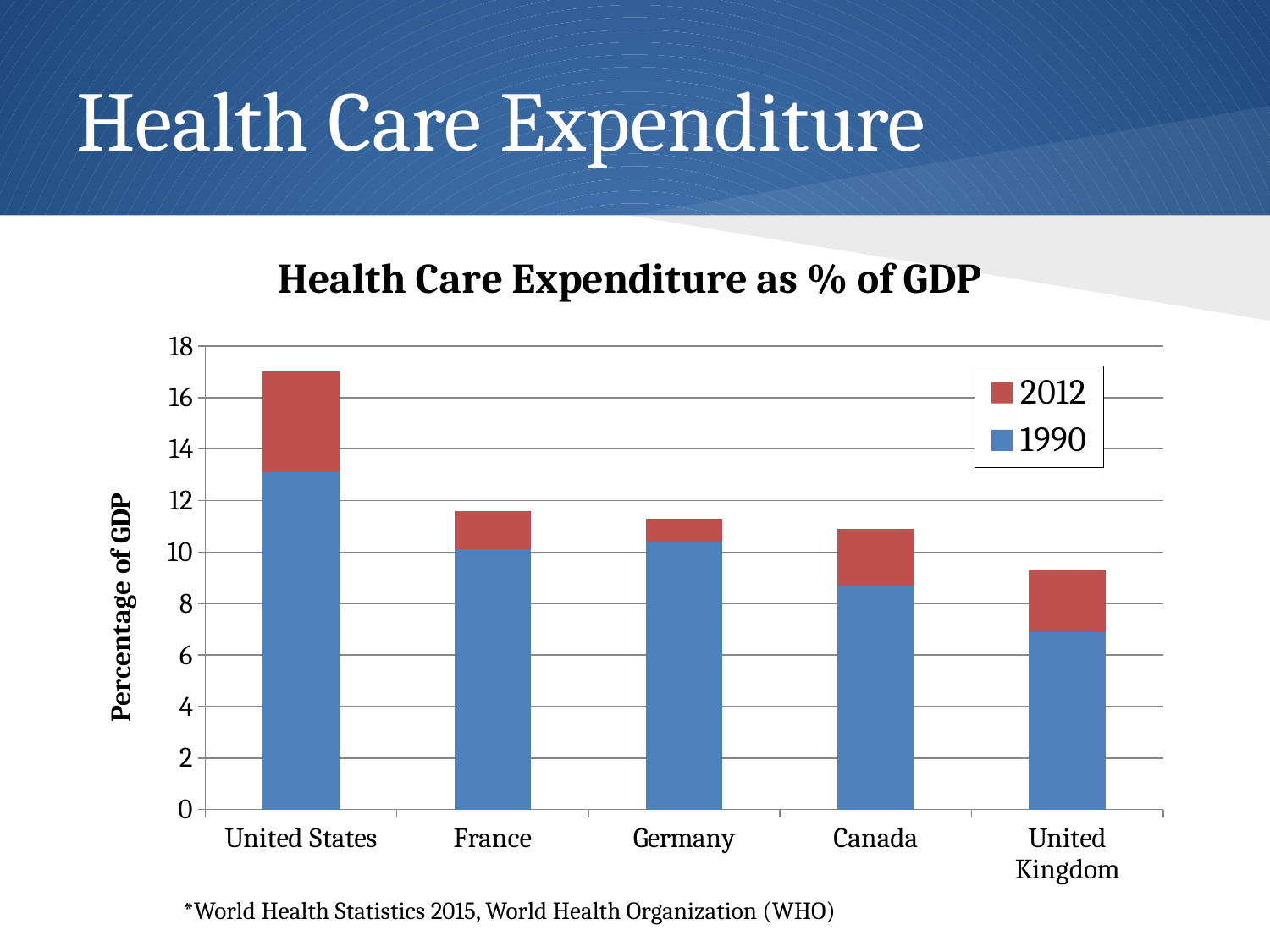
How many series does the chart's legend list? 2 Which country has the shortest stacked bar in the chart? United Kingdom Do the total stacked bar heights rise or fall moving from left to right along the x axis? fall How many countries are shown on the x axis of the chart? 5 Which has the larger total stacked bar, Canada or the United Kingdom? Canada Is the 1990 value for the United Kingdom greater or less than 8? less Is the total stacked value for the United Kingdom greater or less than 10? less What is the label on the chart's vertical axis? Percentage of GDP Is the total stacked value for the United States greater or less than 16? greater Which country has the tallest stacked bar in the chart? United States What kind of chart is shown on the slide? bar chart